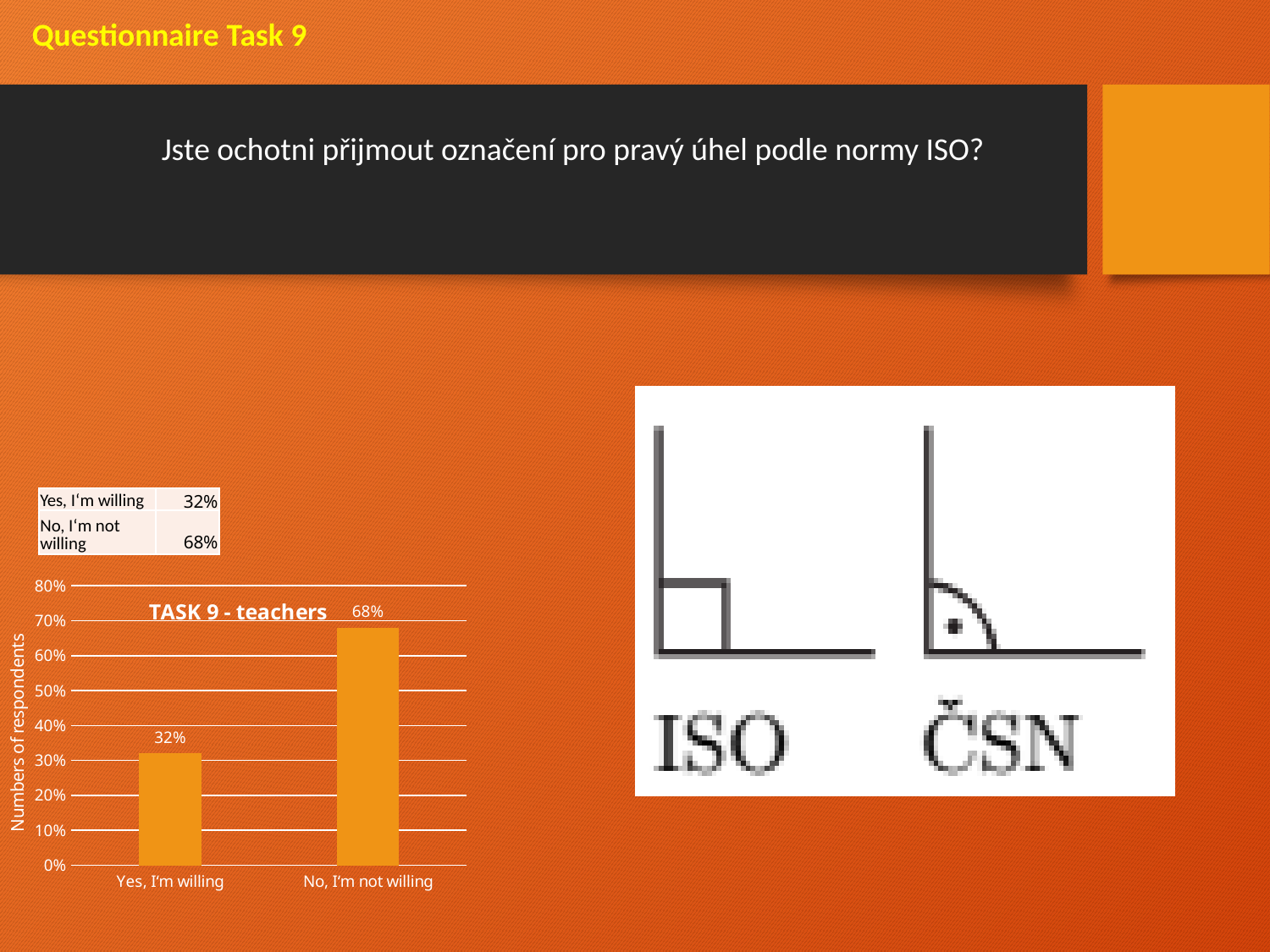
Which category has the highest value in the TASK 9 - teachers chart? No, I'm not willing What is the title of the chart on the slide? TASK 9 - teachers Is the value for "Yes, I'm willing" greater or less than 40%? less Which category has the lowest value in the TASK 9 - teachers chart? Yes, I'm willing Which is larger in the TASK 9 - teachers chart: "Yes, I'm willing" or "No, I'm not willing"? No, I'm not willing What is the value for "Yes, I'm willing" in the TASK 9 - teachers chart? 32% What kind of chart is the TASK 9 - teachers chart? bar chart What is the difference between the values for "No, I'm not willing" and "Yes, I'm willing" in the TASK 9 - teachers chart? 36% What is the value for "No, I'm not willing" in the TASK 9 - teachers chart? 68% How many categories are shown in the TASK 9 - teachers chart? 2 Is the value for "No, I'm not willing" greater or less than 60%? greater What is the label of the vertical axis in the TASK 9 - teachers chart? Numbers of respondents